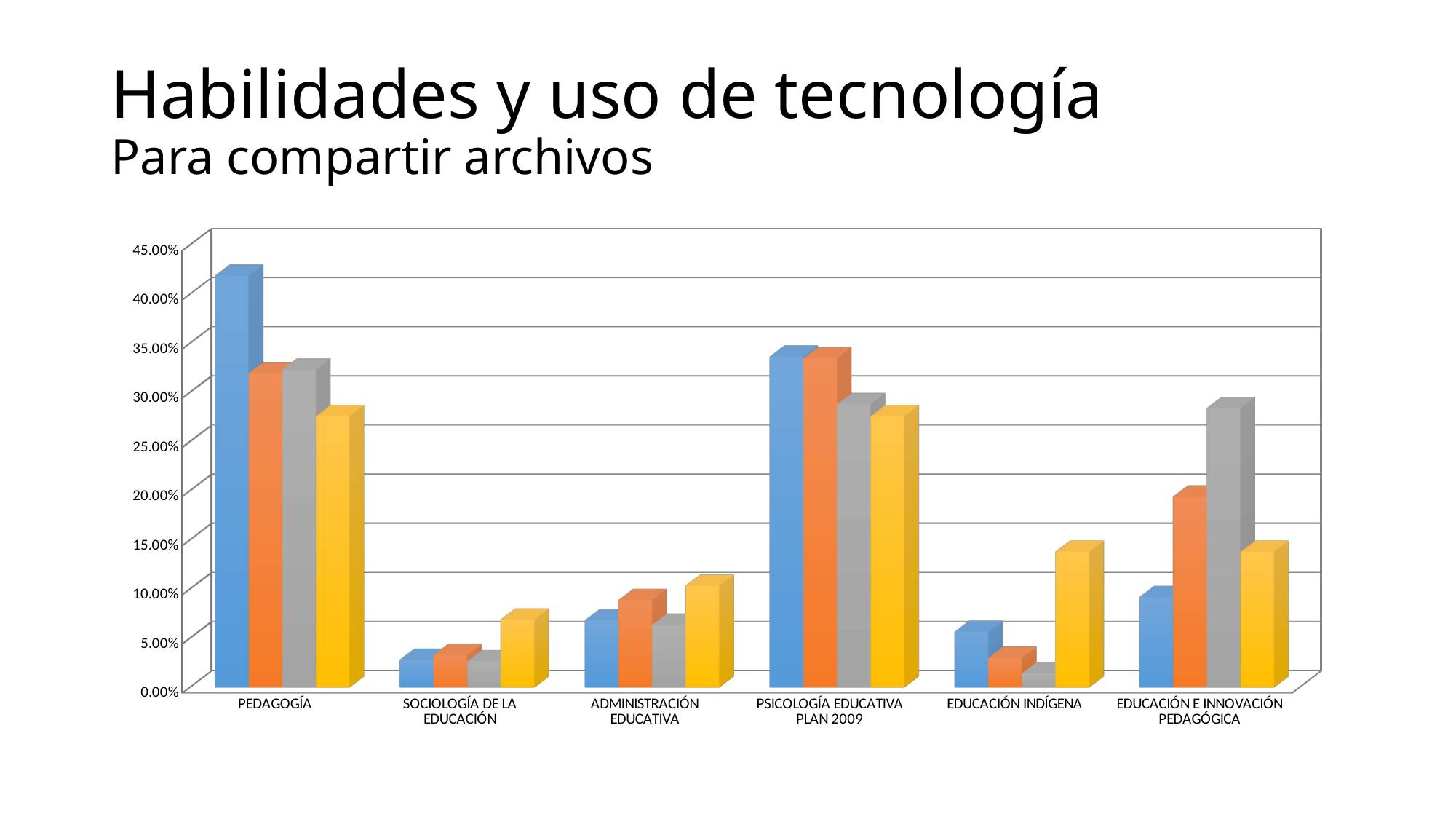
Is the gray bar for EDUCACIÓN INDÍGENA greater or less than 5.00%? less How many bars are plotted for each category in the chart? 4 Which category has the shortest blue bar? SOCIOLOGÍA DE LA EDUCACIÓN For EDUCACIÓN E INNOVACIÓN PEDAGÓGICA, which is larger: the gray bar or the orange bar? the gray bar What is the highest value labelled on the vertical axis of the chart? 45.00% How many categories are shown along the x axis of the chart? 6 Which category has the tallest blue bar? PEDAGOGÍA Is the gray bar for EDUCACIÓN E INNOVACIÓN PEDAGÓGICA greater or less than 25.00%? greater Is the yellow bar for EDUCACIÓN INDÍGENA greater or less than 10.00%? greater Which is larger: the blue bar for PEDAGOGÍA or the blue bar for PSICOLOGÍA EDUCATIVA PLAN 2009? PEDAGOGÍA What kind of chart is shown on the slide? bar chart